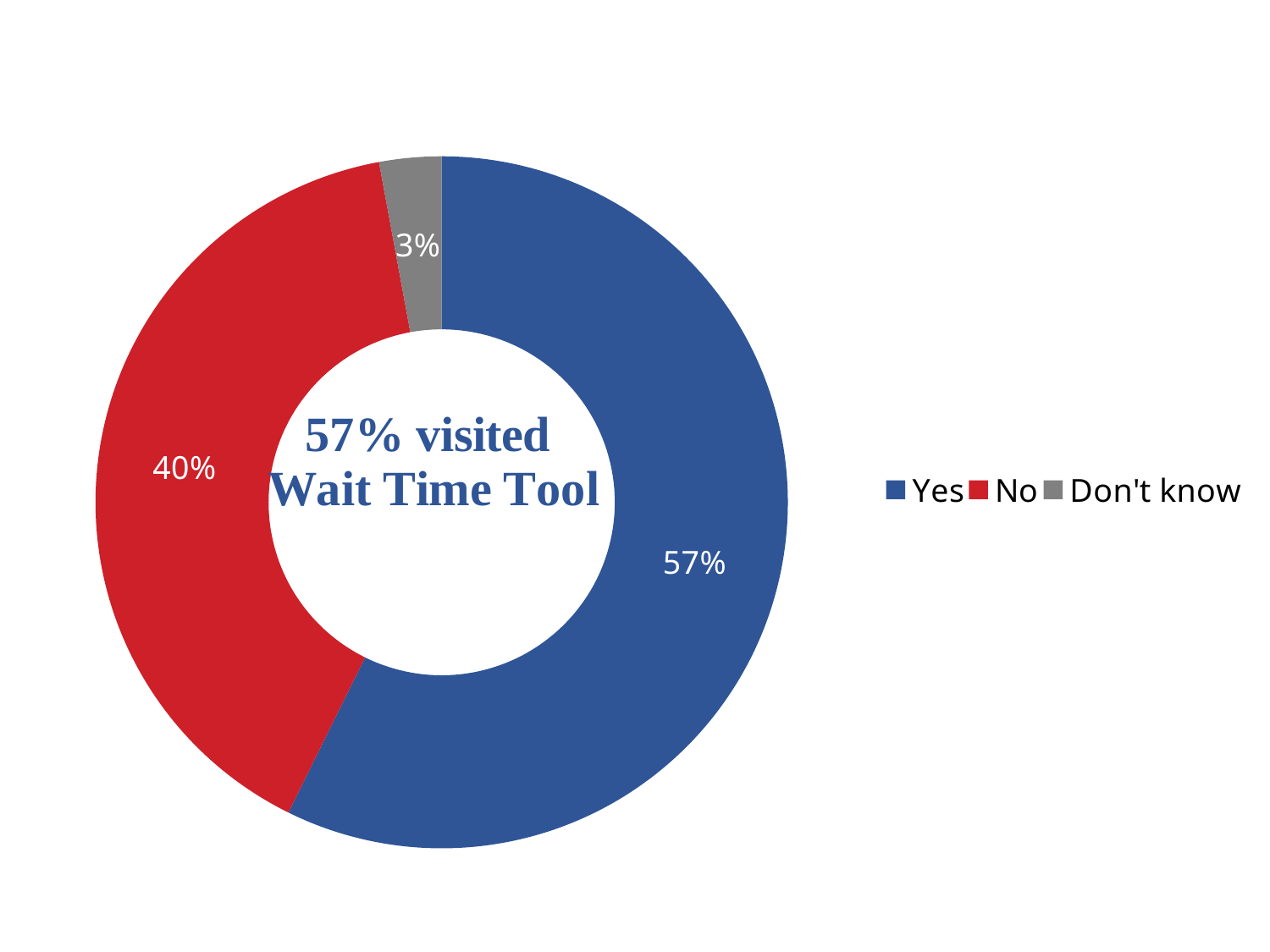
What percentage of respondents answered Yes? 57% Which response has the largest share of the chart? Yes What colour represents the No category? Red What is the difference in percentage points between the Yes and No shares? 17 Which response has the smallest share of the chart? Don't know Which is larger, the share for No or the share for Don't know? No What text is displayed in the centre of the chart? 57% visited Wait Time Tool How many categories are shown in the chart? 3 What is the combined share of the No and Don't know responses? 43% What percentage of respondents answered No? 40% What percentage of respondents answered Don't know? 3% What kind of chart is shown on the slide? Doughnut (pie) chart